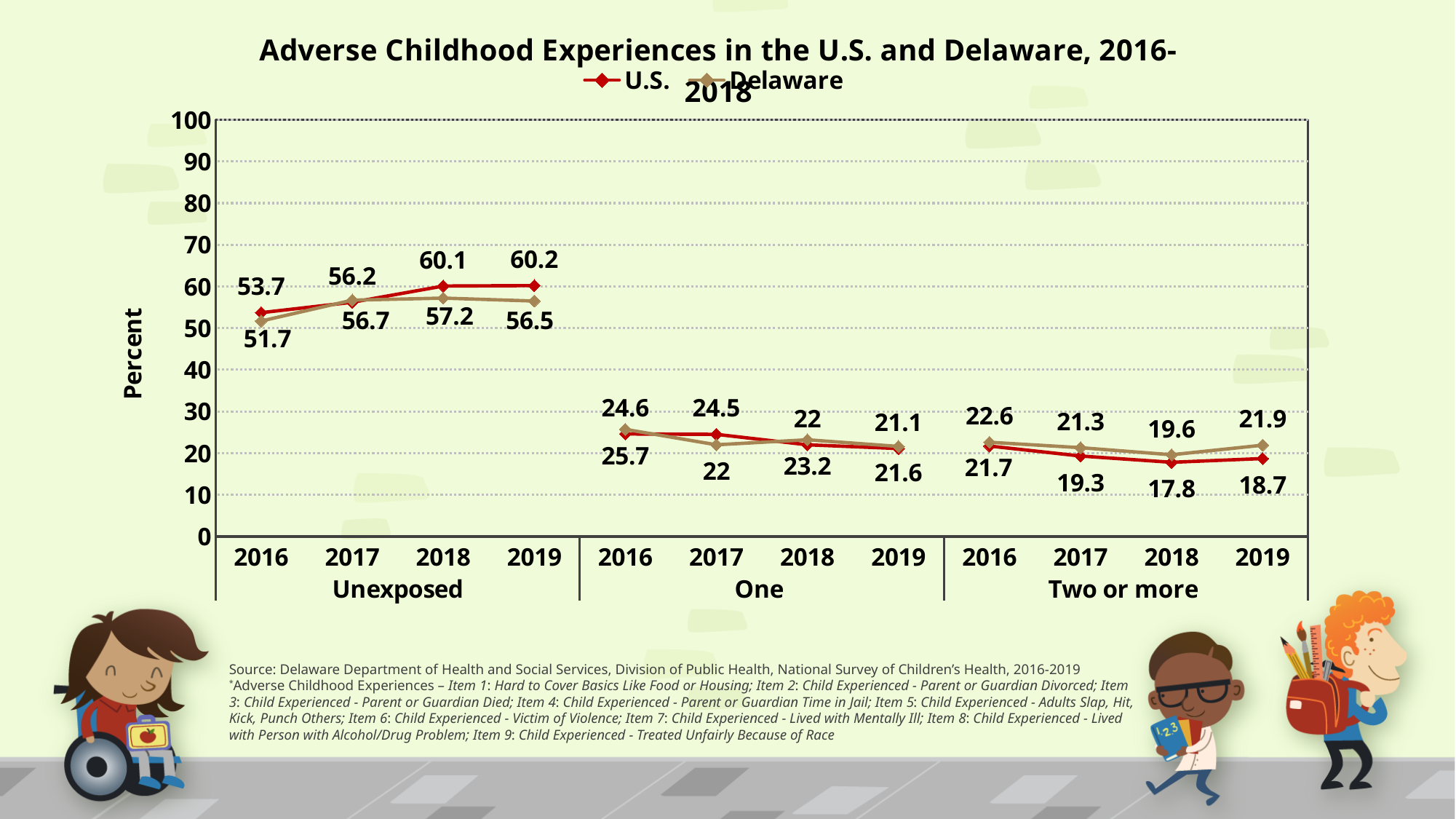
Does the U.S. value for Unexposed rise or fall from 2016 to 2019? rise Which is larger for Two or more in 2017, the U.S. value or the Delaware value? Delaware In which year is the U.S. value for Two or more the lowest? 2018 What is the U.S. value for Unexposed in 2019? 60.2 What is the difference between the U.S. and Delaware values for Unexposed in 2019? 3.7 What is the Delaware value for Two or more in 2019? 21.9 In which year is the U.S. value for Unexposed the highest? 2019 How many series does the legend list? 2 What type of chart is shown on the slide? line chart What is the Delaware value for Unexposed in 2016? 51.7 What label is shown on the vertical axis? Percent What is the U.S. value for One in 2017? 24.5